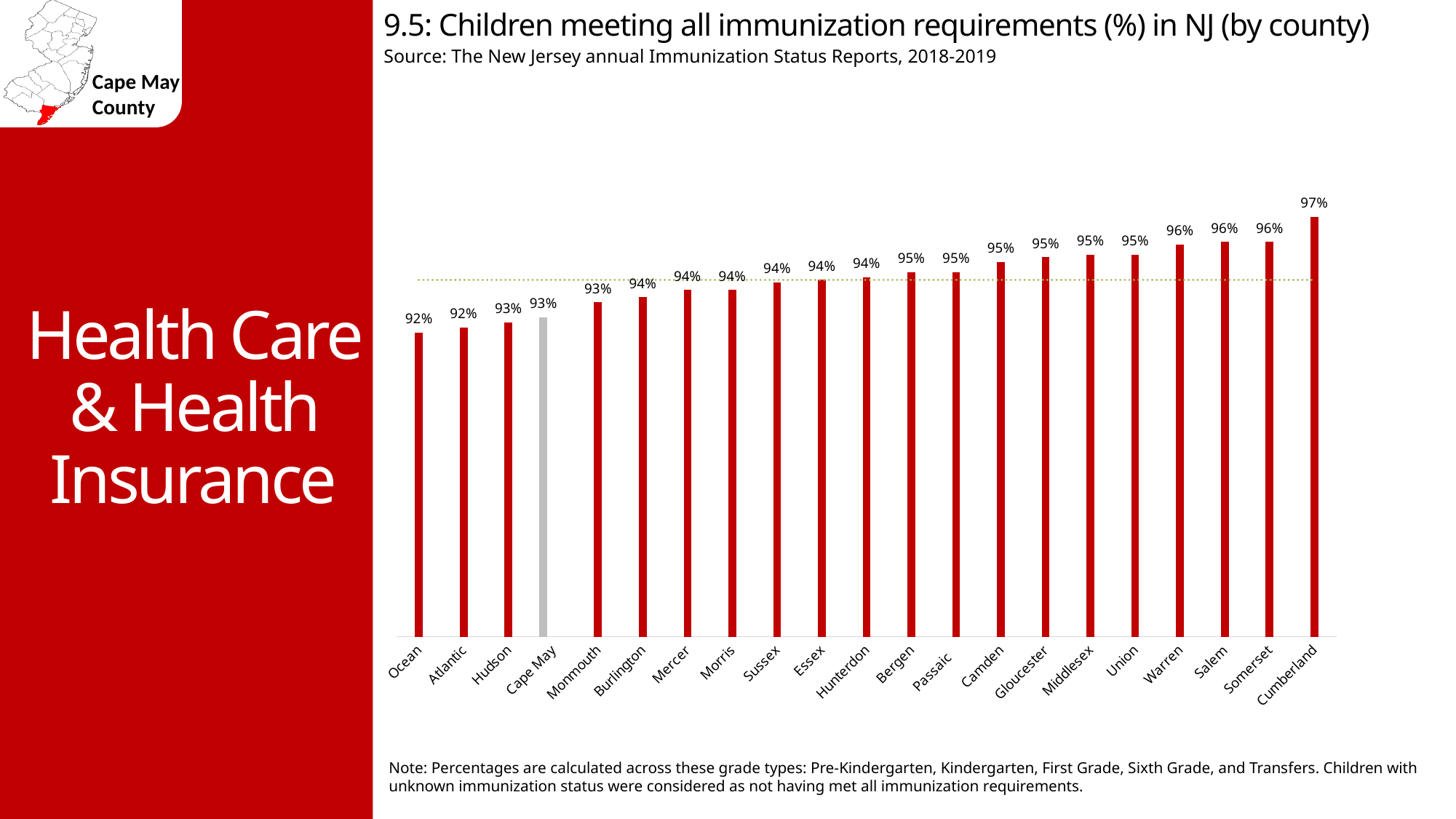
What percentage of children in Cape May County met all immunization requirements? 93% Which has a higher value, Cumberland or Ocean? Cumberland How many counties are shown on the chart? 21 What is the difference in percentage points between Cumberland and Cape May? 4 percentage points What percentage is shown for Bergen County? 95% Which county has the highest percentage of children meeting all immunization requirements? Cumberland What is the value shown for Ocean County? 92% What kind of chart is shown on the slide? Bar chart Do the values generally rise or fall from left to right across the counties? Rise Which county's bar is coloured grey instead of red? Cape May What is the difference in percentage points between Warren and Ocean? 4 percentage points What is the value shown for Cumberland County? 97%